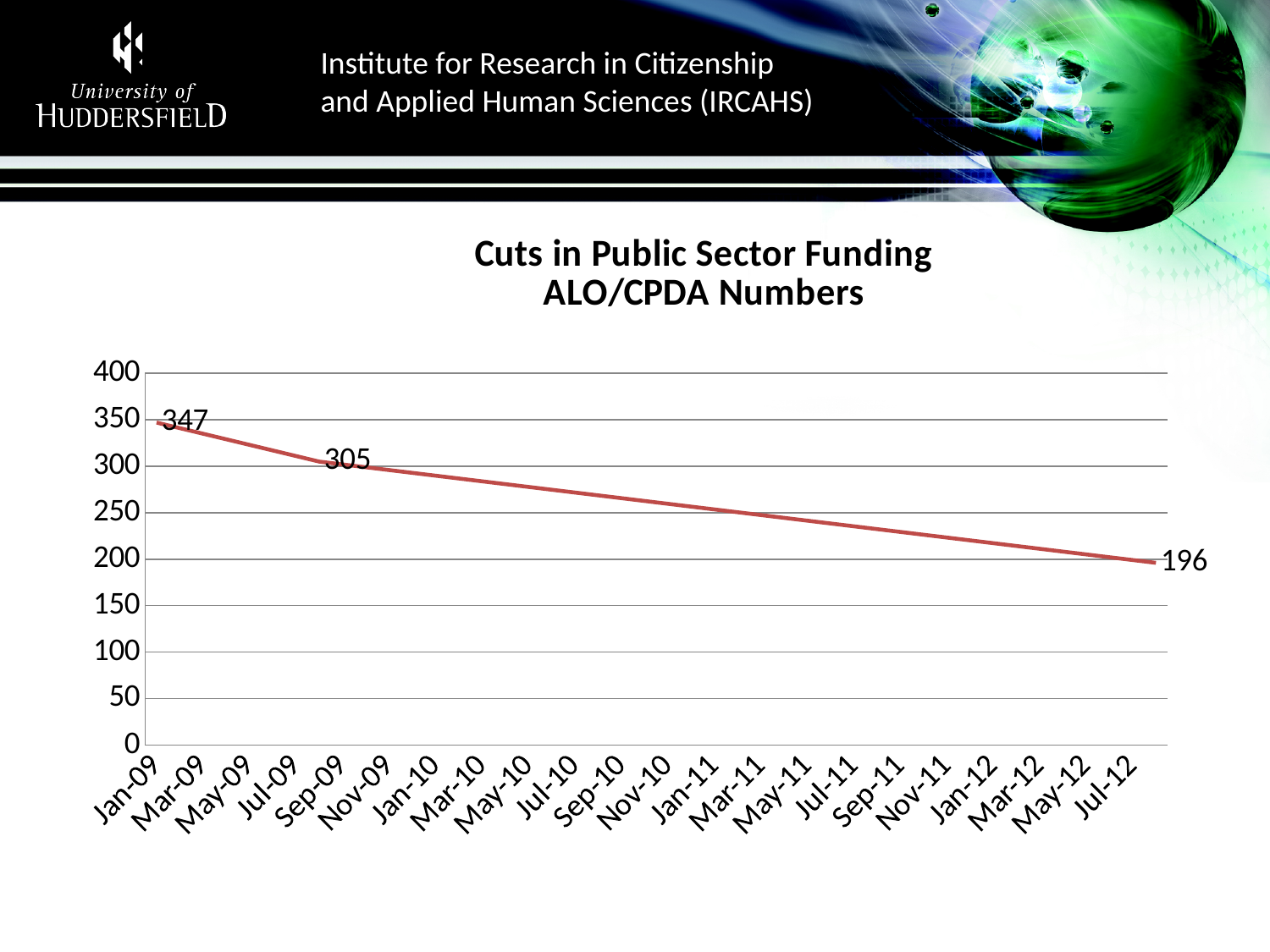
What is the value of the last data point, at Jul-12? 196 What kind of chart is shown on the slide? line chart What is the value shown by the second data label on the line, in late 2009? 305 What is the value of the first data point, at Jan-09? 347 At which x-axis date is the plotted value highest? Jan-09 Is the value of the line at Jan-11 greater or less than 300? less By how much does the value drop from the first labeled point (347) to the second labeled point (305)? 42 What is the difference between the Jan-09 value and the Jul-12 value? 151 Do the values rise or fall from Jan-09 to Jul-12? fall How many date labels are shown along the x axis? 22 What is the title of the chart? Cuts in Public Sector Funding ALO/CPDA Numbers At which x-axis date is the plotted value lowest? Jul-12